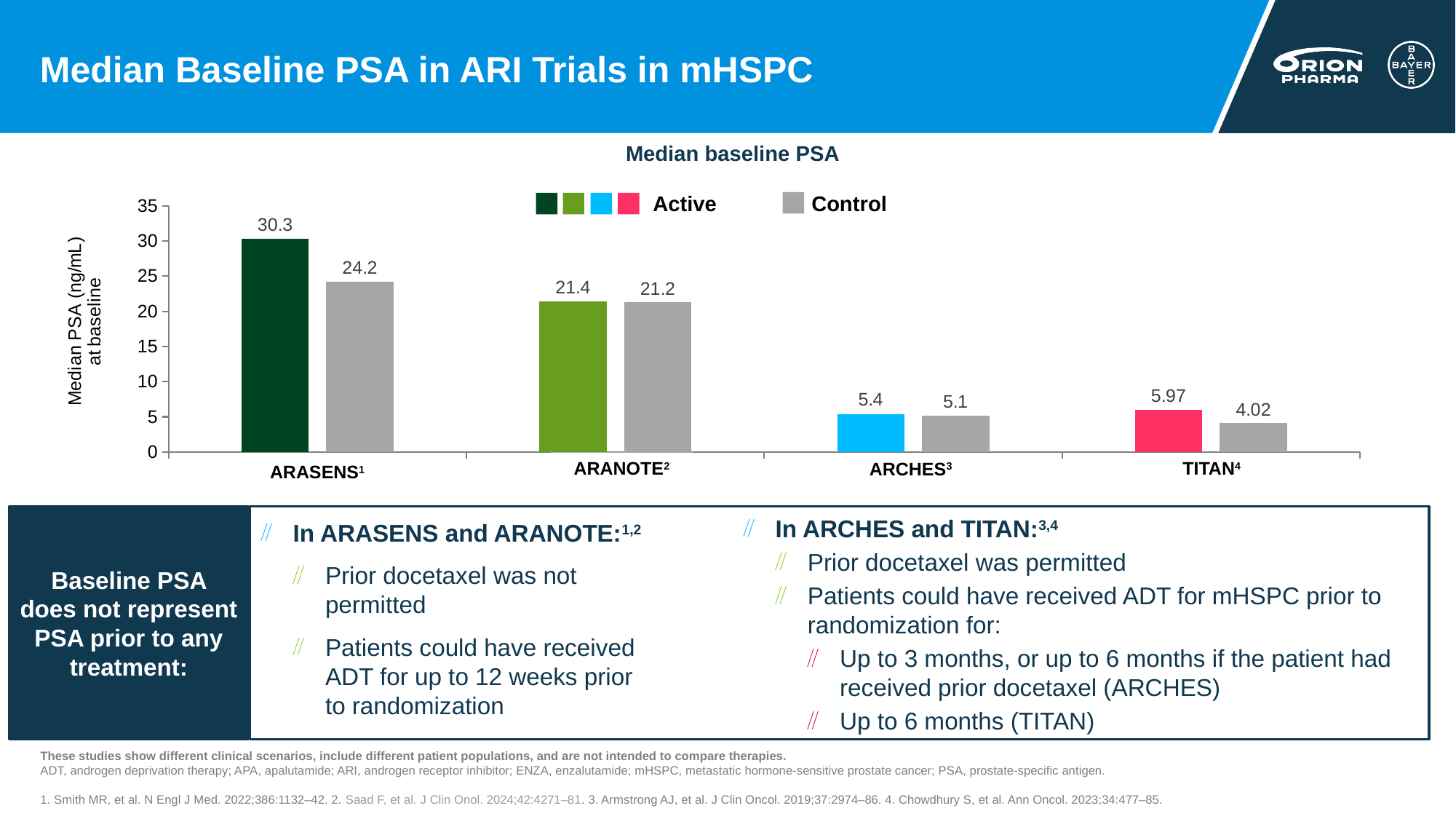
What is the difference between the Active and Control median baseline PSA in ARASENS? 6.1 What is the median baseline PSA for the Control arm in ARANOTE? 21.2 How many series does the chart legend list? 2 What type of chart is used to show median baseline PSA? Bar chart How many trials are shown on the x axis of the chart? 4 What is the median baseline PSA for the Control arm in TITAN? 4.02 What is the median baseline PSA for the Active arm in ARASENS? 30.3 Which trial has the highest Active-arm median baseline PSA? ARASENS Which is larger, the Active-arm median baseline PSA in ARCHES or in TITAN? TITAN Which trial has the lowest Control-arm median baseline PSA? TITAN What is the difference between the Active and Control median baseline PSA in TITAN? 1.95 Is the Control-arm median baseline PSA in ARASENS greater or less than 25? less